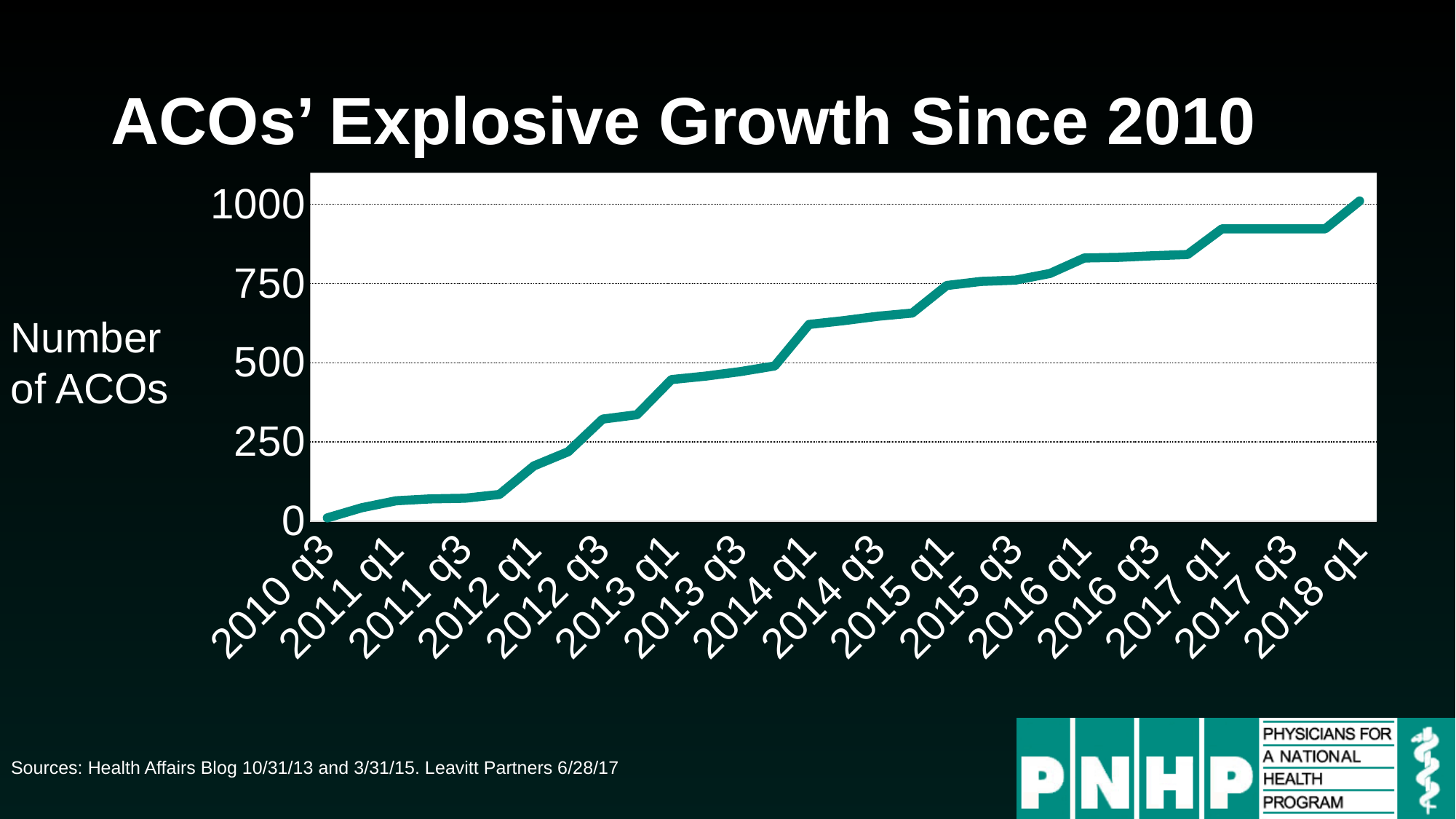
Is the number of ACOs in 2012 q3 greater or less than 250? greater Which period has the highest number of ACOs? 2018 q1 Which period has the lowest number of ACOs? 2010 q3 Which period has more ACOs, 2012 q1 or 2014 q1? 2014 q1 Is the number of ACOs in 2017 q1 greater or less than 750? greater Is the number of ACOs in 2014 q1 greater or less than 500? greater Do the values rise or fall along the x axis from 2010 q3 to 2018 q1? rise What does the vertical axis of the chart measure? Number of ACOs What is the title of the chart? ACOs' Explosive Growth Since 2010 What kind of chart is shown on the slide? line chart